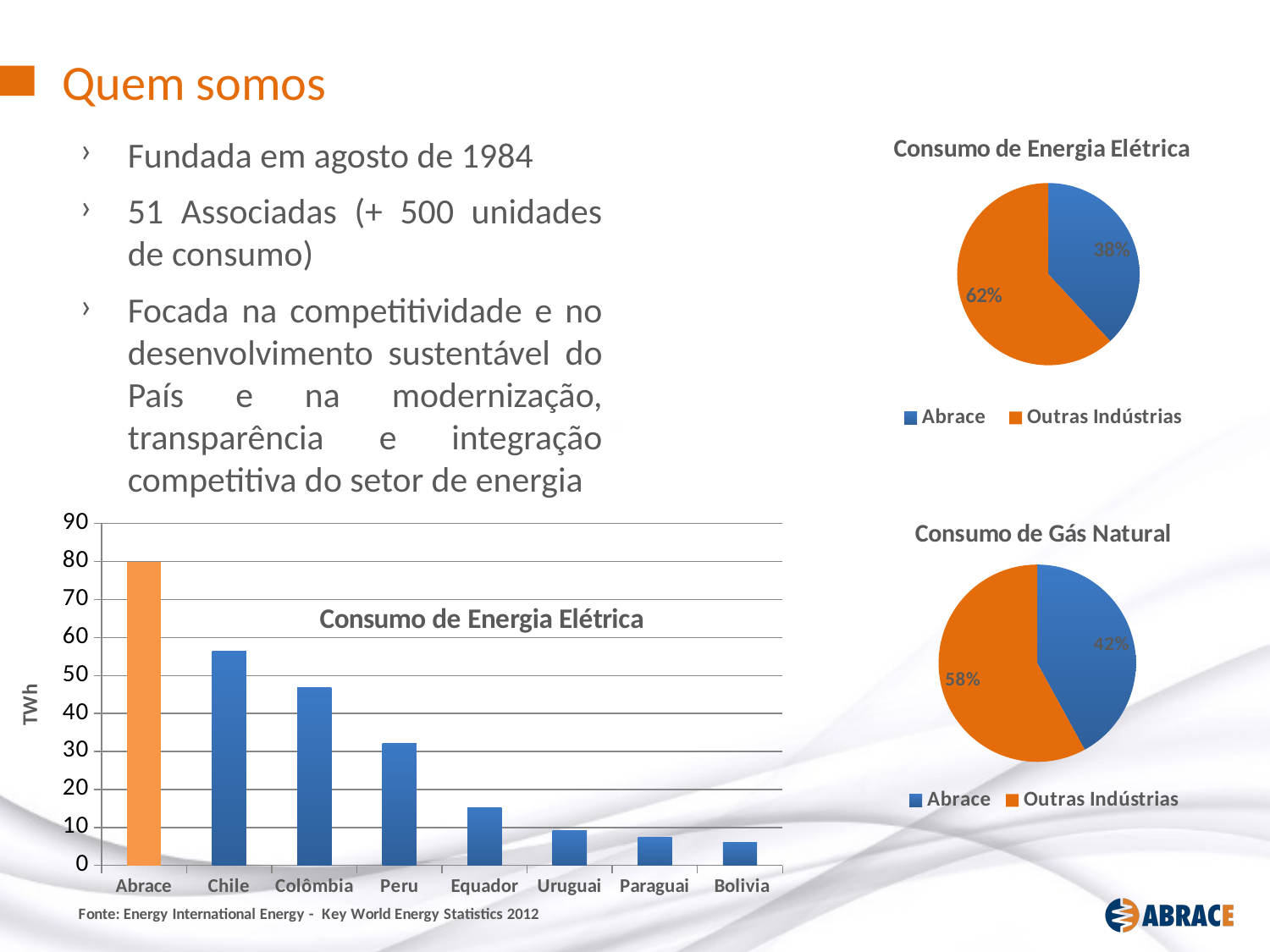
In the pie chart titled 'Consumo de Energia Elétrica' at the top right, what share do Outras Indústrias have? 62% In the bar chart at the bottom left, which category has the highest value? Abrace In the pie chart titled 'Consumo de Gás Natural', what share do Outras Indústrias have? 58% In the pie chart titled 'Consumo de Energia Elétrica' at the top right, which slice is larger, Abrace or Outras Indústrias? Outras Indústrias How many categories are shown on the x axis of the bar chart at the bottom left? 8 In the pie chart titled 'Consumo de Energia Elétrica' at the top right, what share does Abrace have? 38% What kind of chart is the 'Consumo de Energia Elétrica' chart at the bottom left of the slide? bar chart How many entries does the legend of the 'Consumo de Gás Natural' chart list? 2 In the bar chart at the bottom left, is the value for Chile greater or less than 50? greater In the bar chart at the bottom left, which category has the lowest value? Bolivia In the pie chart titled 'Consumo de Gás Natural', what is the difference between the Outras Indústrias share and the Abrace share? 16%